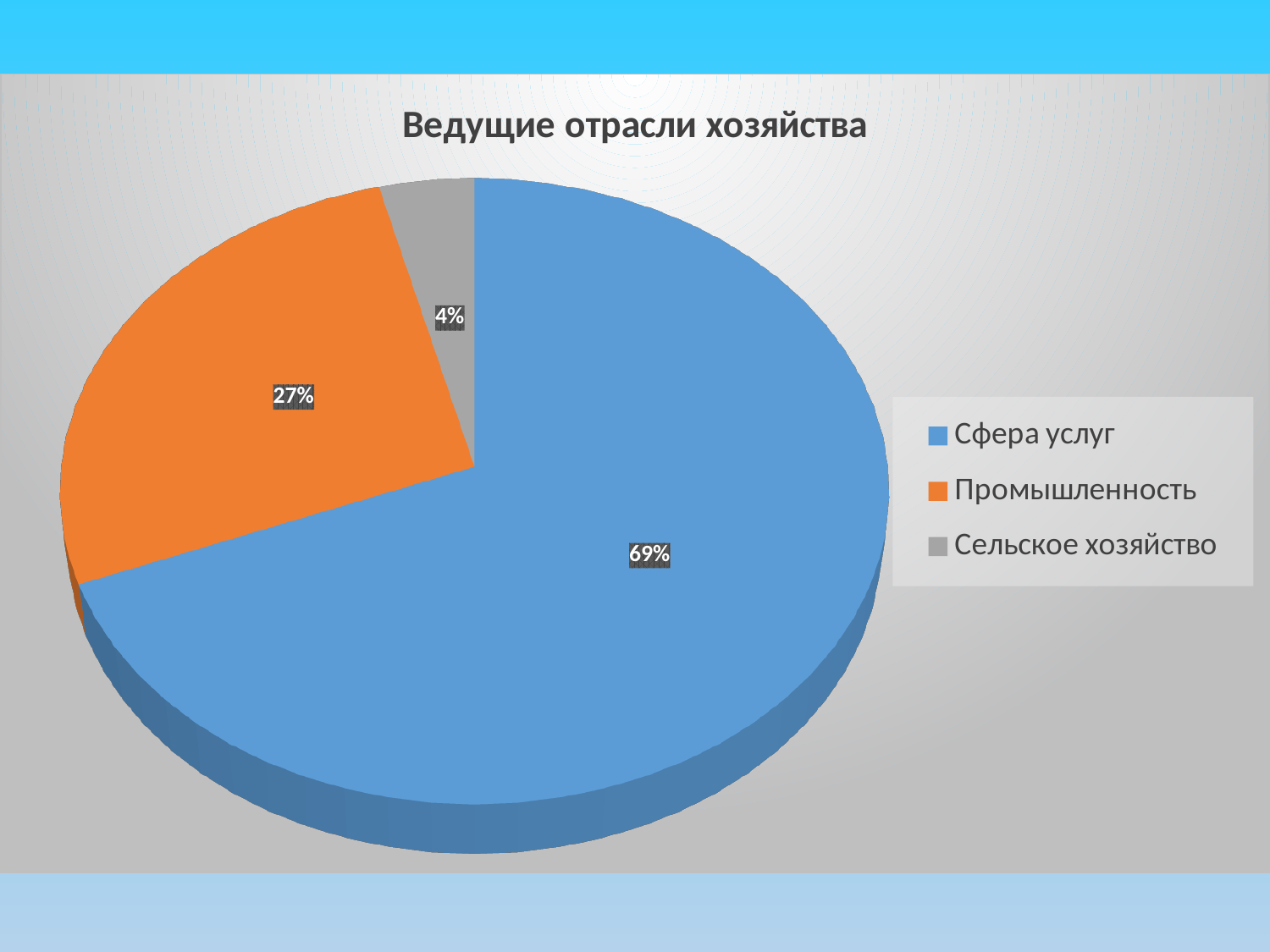
Which is larger, the slice for Промышленность or the slice for Сельское хозяйство? Промышленность Which category has the smallest slice of the pie? Сельское хозяйство What share of the pie does Сфера услуг have? 69% What is the title of the chart? Ведущие отрасли хозяйства How many categories are shown in the pie chart? 3 Which category has the largest slice of the pie? Сфера услуг What is the difference in percentage points between Промышленность and Сельское хозяйство? 23 What is the difference in percentage points between Сфера услуг and Промышленность? 42 What kind of chart is shown on the slide? Pie chart What share of the pie does Промышленность have? 27% What share of the pie does Сельское хозяйство have? 4% What colour is the slice for Промышленность? Orange